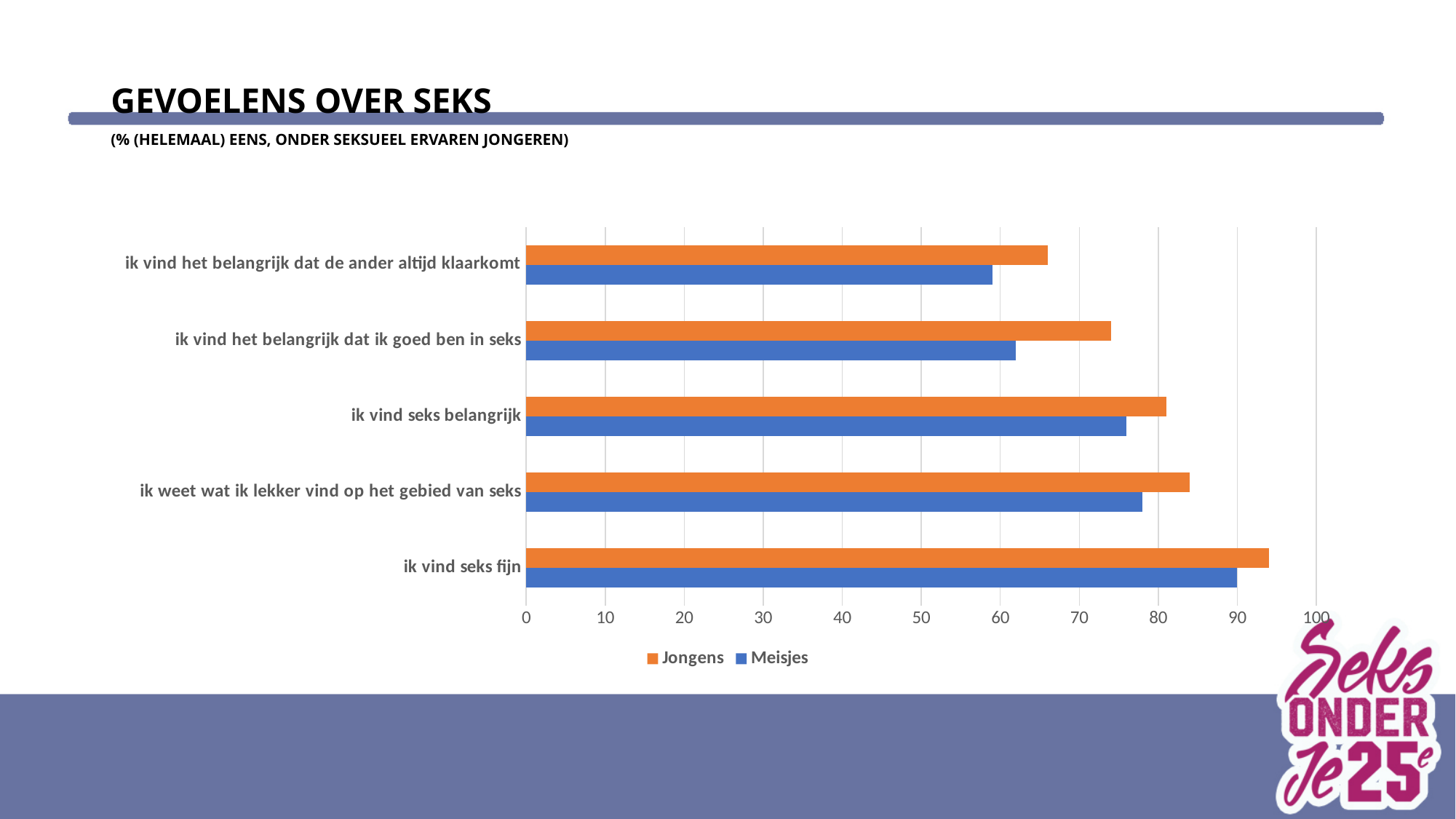
Is the value for Meisjes on 'ik vind het belangrijk dat ik goed ben in seks' greater or less than 70? less How many series does the legend list? 2 Which statement has the highest value for Jongens? ik vind seks fijn Is the value for Jongens on 'ik vind seks fijn' greater or less than 90? greater Which colour represents Meisjes in the chart? blue How many statements (categories) are shown on the chart? 5 Is the value for Jongens on 'ik weet wat ik lekker vind op het gebied van seks' greater or less than 80? greater Which statement has the lowest value for Meisjes? ik vind het belangrijk dat de ander altijd klaarkomt What kind of chart is shown on the slide? bar chart For 'ik vind het belangrijk dat ik goed ben in seks', which is larger: Jongens or Meisjes? Jongens For 'ik vind het belangrijk dat de ander altijd klaarkomt', which is larger: Jongens or Meisjes? Jongens